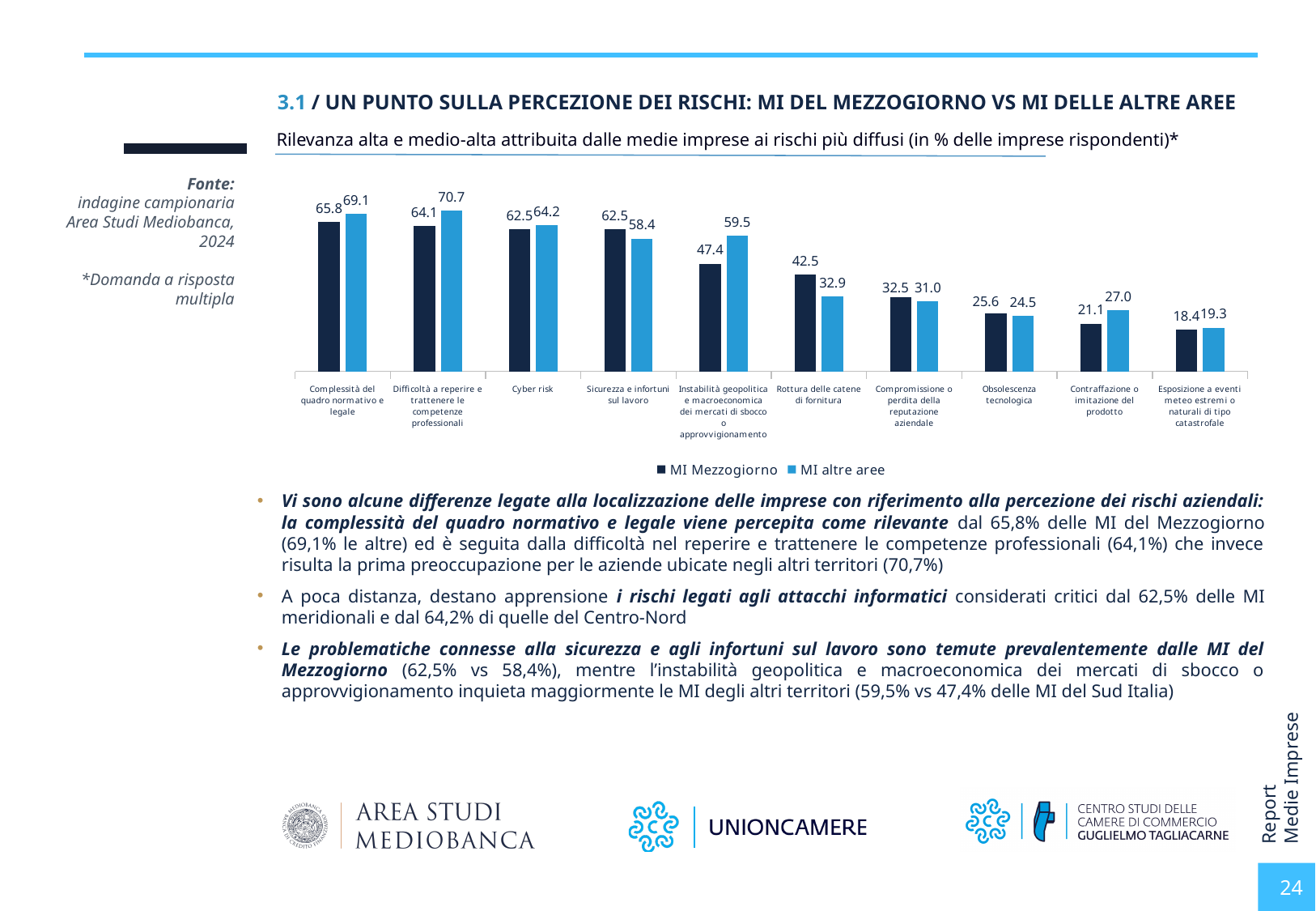
What type of chart is shown on the slide? Bar chart What is the value for MI altre aree for Contraffazione o imitazione del prodotto? 27.0 How many risk categories are shown on the x axis of the chart? 10 Which series is shown in light blue in the chart legend? MI altre aree Which category has the highest value for MI Mezzogiorno? Complessità del quadro normativo e legale What is the value for MI altre aree for Difficoltà a reperire e trattenere le competenze professionali? 70.7 What is the value for MI Mezzogiorno for Cyber risk? 62.5 What is the difference between MI altre aree and MI Mezzogiorno for Instabilità geopolitica e macroeconomica dei mercati di sbocco o approvvigionamento? 12.1 How many series does the chart legend list? 2 Which category has the lowest value for MI altre aree? Esposizione a eventi meteo estremi o naturali di tipo catastrofale What is the value for MI Mezzogiorno for Rottura delle catene di fornitura? 42.5 For Sicurezza e infortuni sul lavoro, which series has the larger value, MI Mezzogiorno or MI altre aree? MI Mezzogiorno